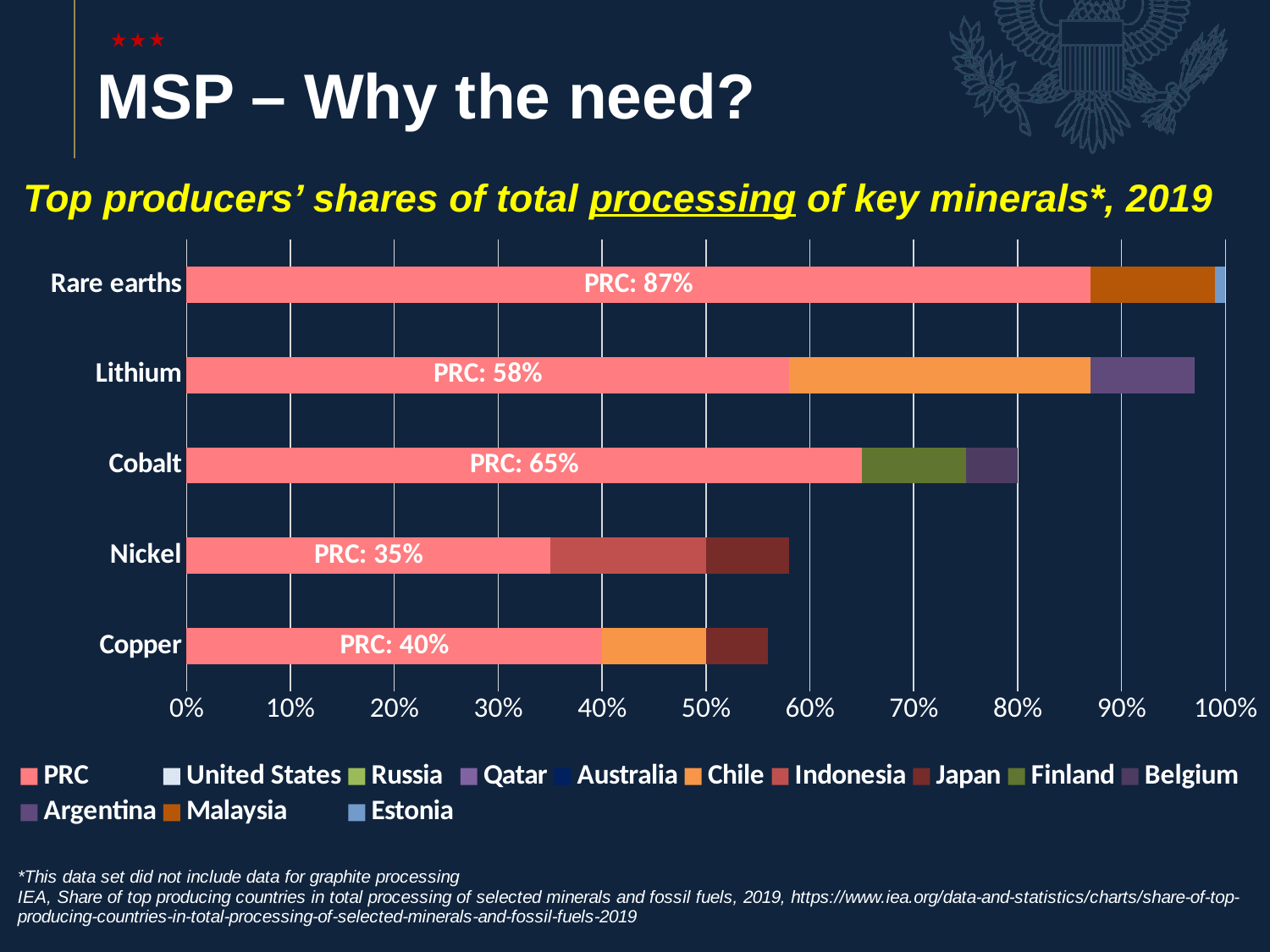
Is the total stacked bar for Lithium greater or less than 90%? greater How many countries does the legend list? 13 How many minerals are shown on the chart? 5 For which mineral is the PRC's processing share the lowest? Nickel What is the difference between the PRC's share of rare earths processing and its share of lithium processing? 29% Is the PRC's processing share larger for cobalt or for copper? Cobalt For which mineral is the PRC's processing share the highest? Rare earths What type of chart is shown on the slide? Stacked bar chart What is the PRC's share of lithium processing shown on the chart? 58% What is the PRC's share of cobalt processing shown on the chart? 65% What is the PRC's share of nickel processing shown on the chart? 35% What is the PRC's share of rare earths processing shown on the chart? 87%